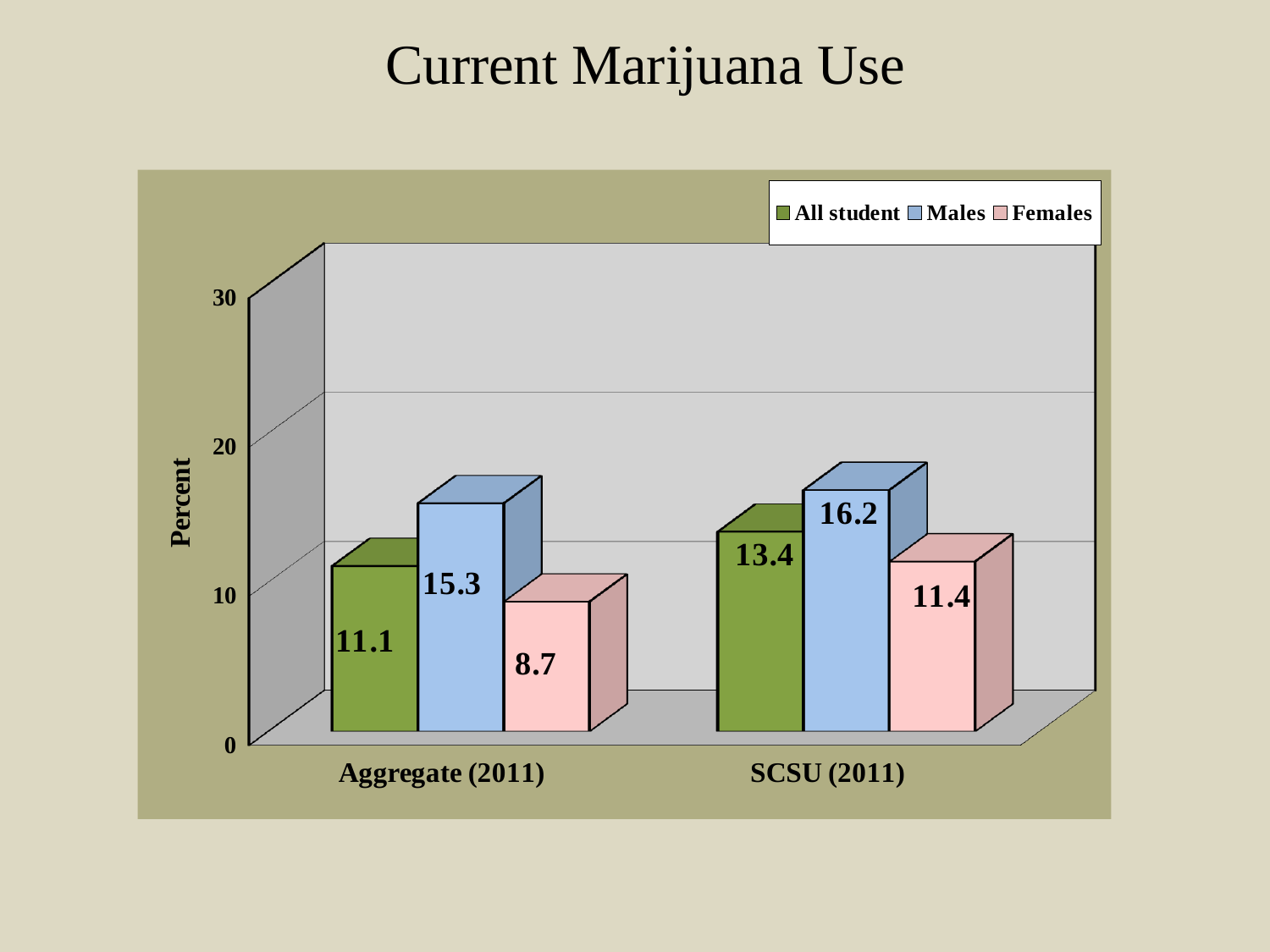
How many series does the legend list? 3 What is the difference between the Males values for SCSU (2011) and Aggregate (2011)? 0.9 What is the value for Females in the SCSU (2011) category? 11.4 What kind of chart is shown on the slide? bar chart What is the value for Males in the Aggregate (2011) category? 15.3 Which is larger: the Females value for Aggregate (2011) or the Females value for SCSU (2011)? SCSU (2011) How many categories are shown on the x axis? 2 Which series has the highest value in the SCSU (2011) category? Males Is the value for Males in SCSU (2011) greater or less than 20? less What is the value for All student in the SCSU (2011) category? 13.4 Which series has the lowest value in the Aggregate (2011) category? Females What is the difference between the Males and Females values in the Aggregate (2011) category? 6.6